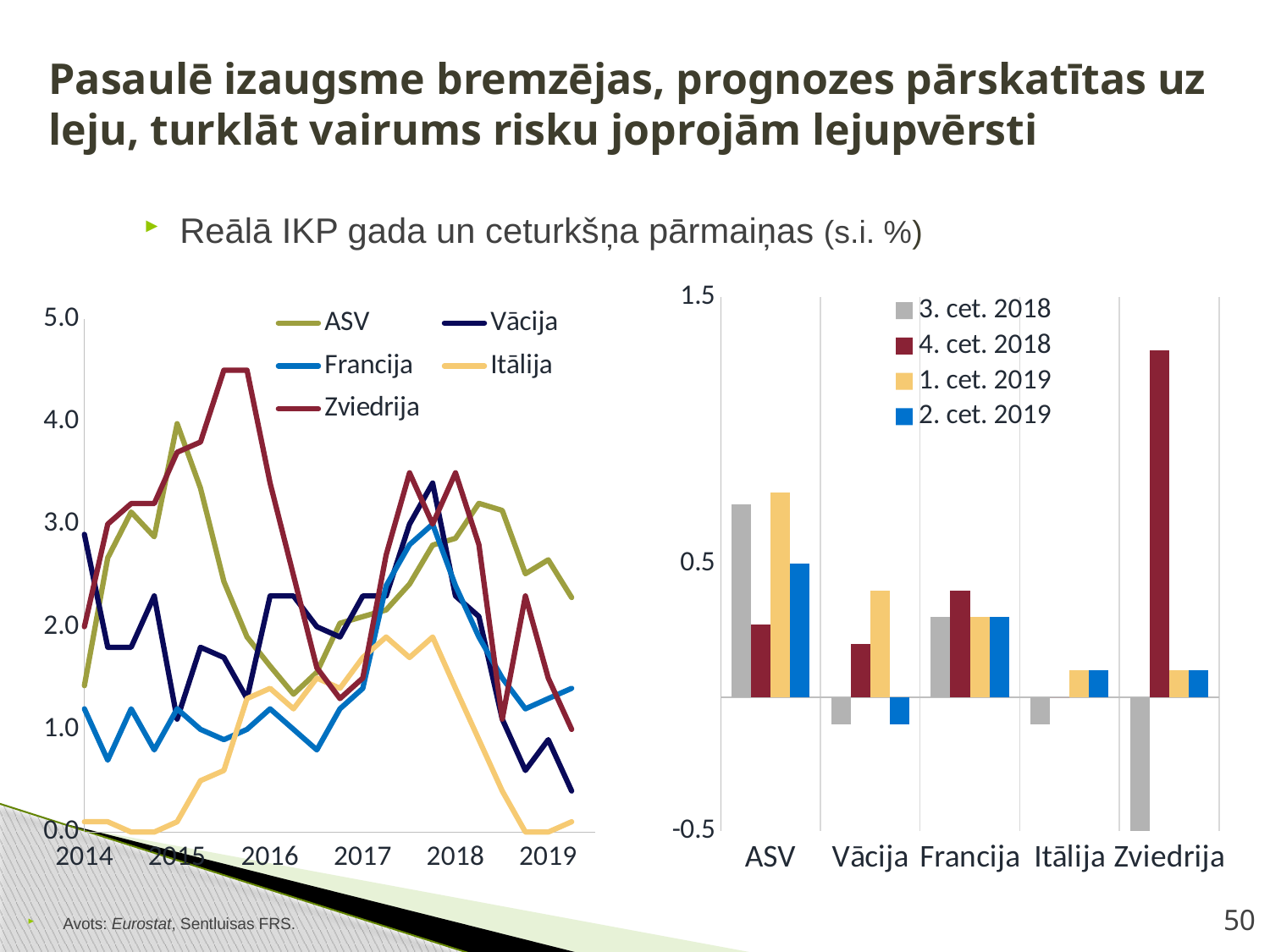
In the line chart on the left, which series reaches the highest value over the whole period? Zviedrija In the bar chart on the right, how many series does the legend list? 4 In the line chart on the left, does the Itālija line rise or fall between 2018 and 2019? fall In the bar chart on the right, is the value for ASV in 3. cet. 2018 greater or less than 0.5? greater In the bar chart on the right, is the value for Vācija in 2. cet. 2019 greater or less than 0? less In the bar chart on the right, which is larger for 1. cet. 2019: ASV or Francija? ASV What kind of chart is the chart on the left of the slide? line chart In the bar chart on the right, how many countries are shown on the x axis? 5 In the line chart on the left, how many series does the legend list? 5 What kind of chart is the chart on the right of the slide? bar chart In the bar chart on the right, which country has the highest value for 4. cet. 2018? Zviedrija In the bar chart on the right, is the value for Zviedrija in 3. cet. 2018 greater or less than 0? less